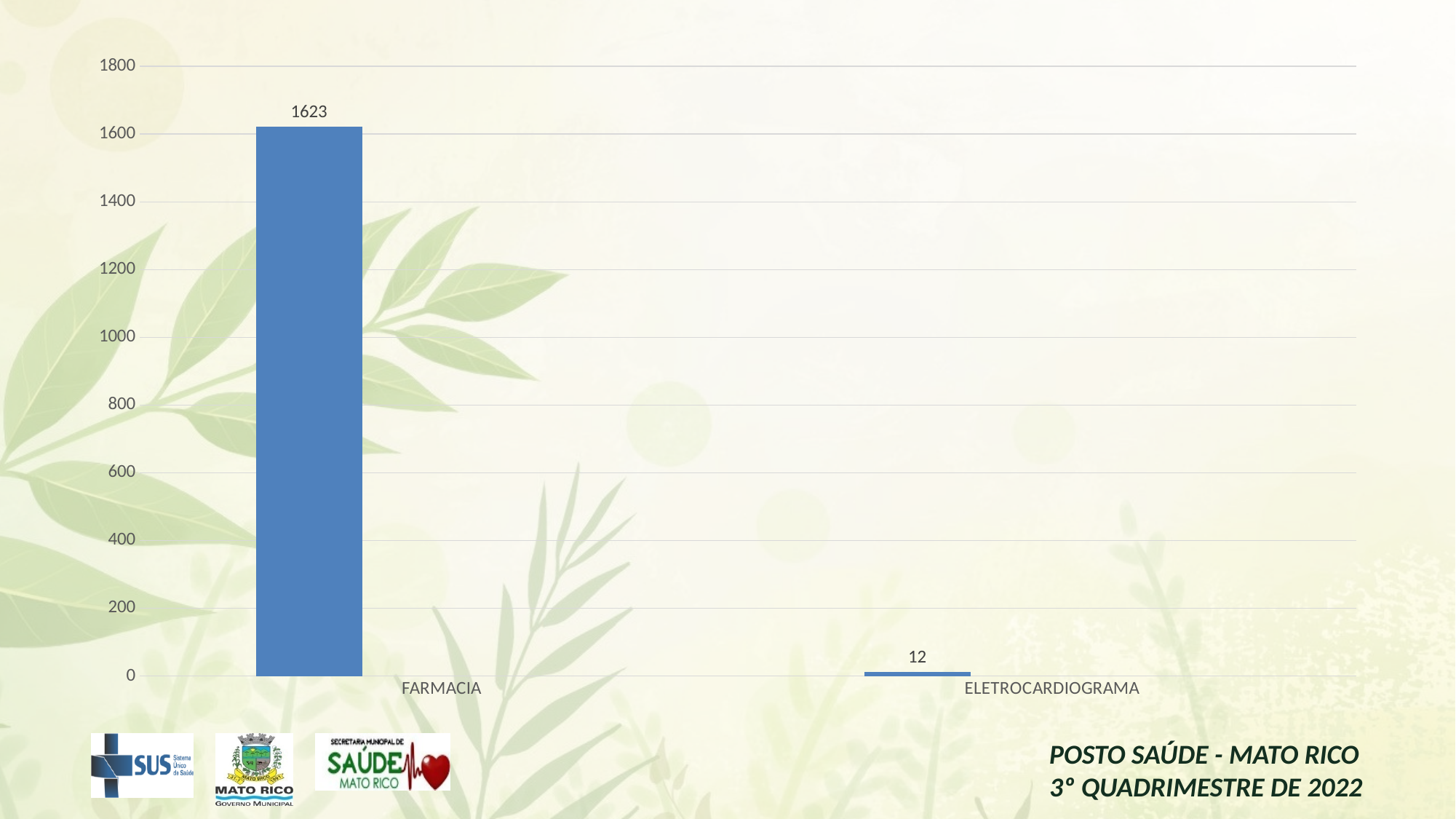
What is the value for FARMACIA? 1623 Is the value for ELETROCARDIOGRAMA greater or less than 200? less Which category has the highest value? FARMACIA Which category has the lowest value? ELETROCARDIOGRAMA What colour are the bars in the chart? blue What is the difference between the values for FARMACIA and ELETROCARDIOGRAMA? 1611 What is the value for ELETROCARDIOGRAMA? 12 What kind of chart is shown on the slide? bar chart Which is larger, the value for FARMACIA or the value for ELETROCARDIOGRAMA? FARMACIA Is the value for FARMACIA greater or less than 1600? greater How many categories are shown in the chart? 2 What is the highest value shown on the vertical axis? 1800